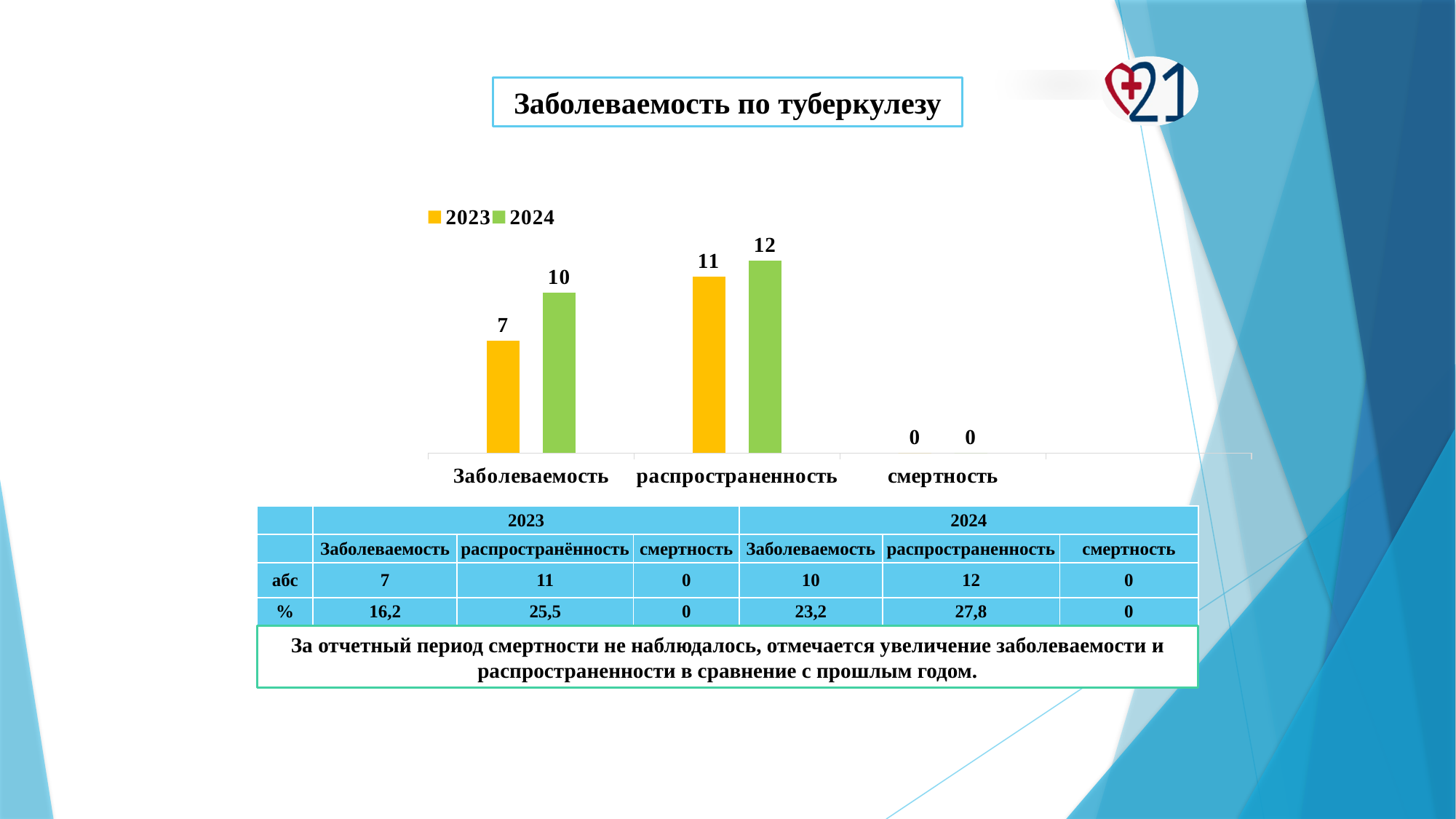
What kind of chart is shown on the slide? bar chart What is the difference between the 2024 and 2023 values for распространенность? 1 How many series does the legend list? 2 What is the value for смертность in 2023? 0 What is the value for Заболеваемость in 2023? 7 What is the value for распространенность in 2024? 12 Which category has the lowest value for the 2023 series? смертность Which category has the highest value for the 2024 series? распространенность What is the difference between the 2024 and 2023 values for Заболеваемость? 3 How many categories are shown on the x axis of the chart? 3 What is the value for Заболеваемость in 2024? 10 Which is larger for Заболеваемость: the 2023 value or the 2024 value? 2024